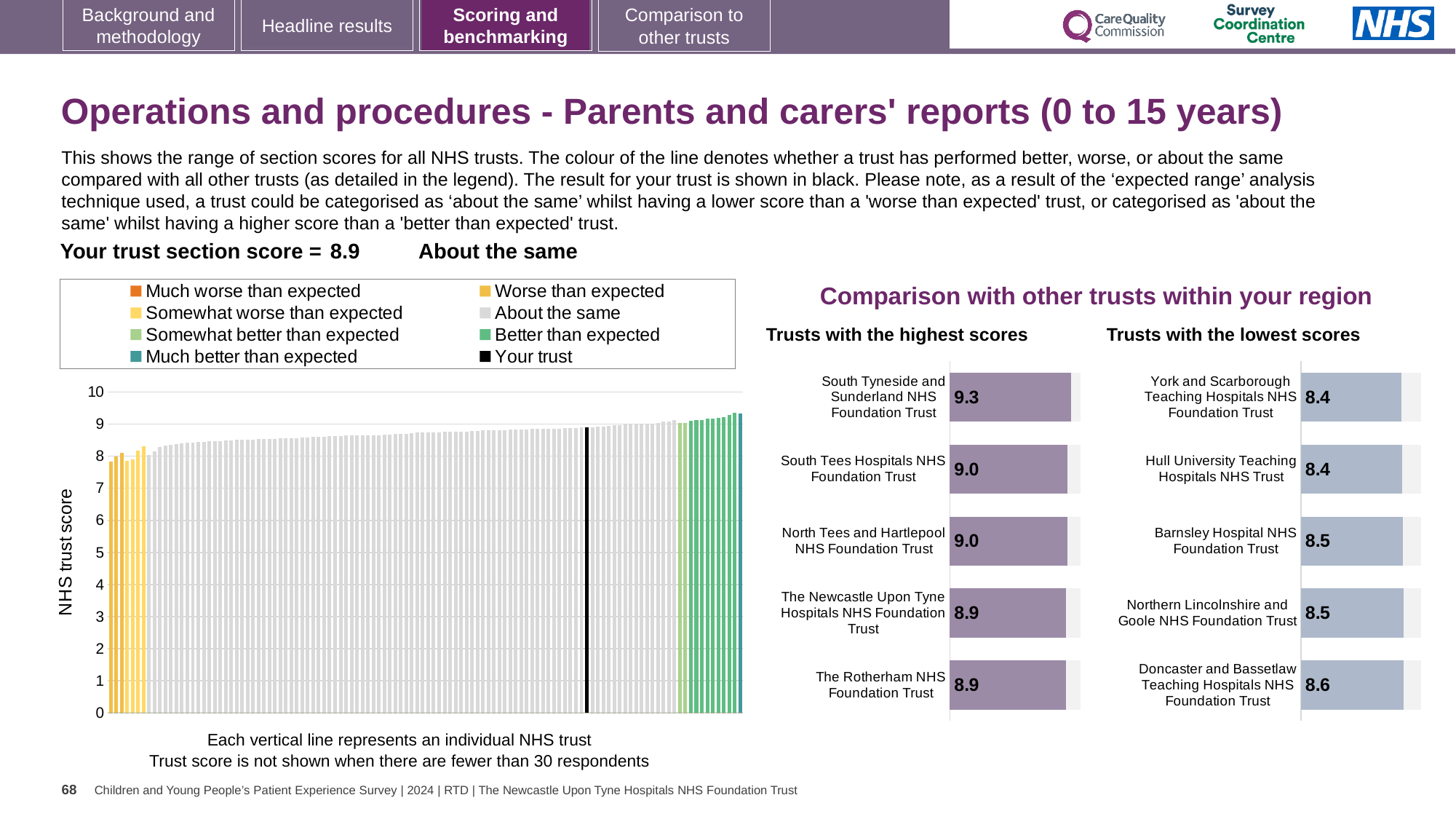
In the 'Trusts with the lowest scores' chart, what is the difference between the scores of Doncaster and Bassetlaw Teaching Hospitals NHS Foundation Trust and Hull University Teaching Hospitals NHS Trust? 0.2 In the 'Trusts with the lowest scores' chart, what is the score for Doncaster and Bassetlaw Teaching Hospitals NHS Foundation Trust? 8.6 In the 'Trusts with the lowest scores' chart, which has the larger score: Barnsley Hospital NHS Foundation Trust or York and Scarborough Teaching Hospitals NHS Foundation Trust? Barnsley Hospital NHS Foundation Trust How many entries does the legend of the main 'NHS trust score' chart on the left list? 8 In the main 'NHS trust score' chart on the left, do the bar values rise or fall from left to right along the x axis? rise In the 'Trusts with the highest scores' chart, what is the difference between the scores of South Tyneside and Sunderland NHS Foundation Trust and The Newcastle Upon Tyne Hospitals NHS Foundation Trust? 0.4 In the 'Trusts with the highest scores' chart, what is the score for South Tyneside and Sunderland NHS Foundation Trust? 9.3 In the 'Trusts with the highest scores' chart, what is the score for The Rotherham NHS Foundation Trust? 8.9 In the 'Trusts with the lowest scores' chart, which trust has the highest score shown? Doncaster and Bassetlaw Teaching Hospitals NHS Foundation Trust How many trusts are shown in the 'Trusts with the highest scores' chart? 5 In the main 'NHS trust score' chart on the left, is the value for the black 'Your trust' bar greater or less than 8? greater In the 'Trusts with the highest scores' chart, which trust has the highest score? South Tyneside and Sunderland NHS Foundation Trust